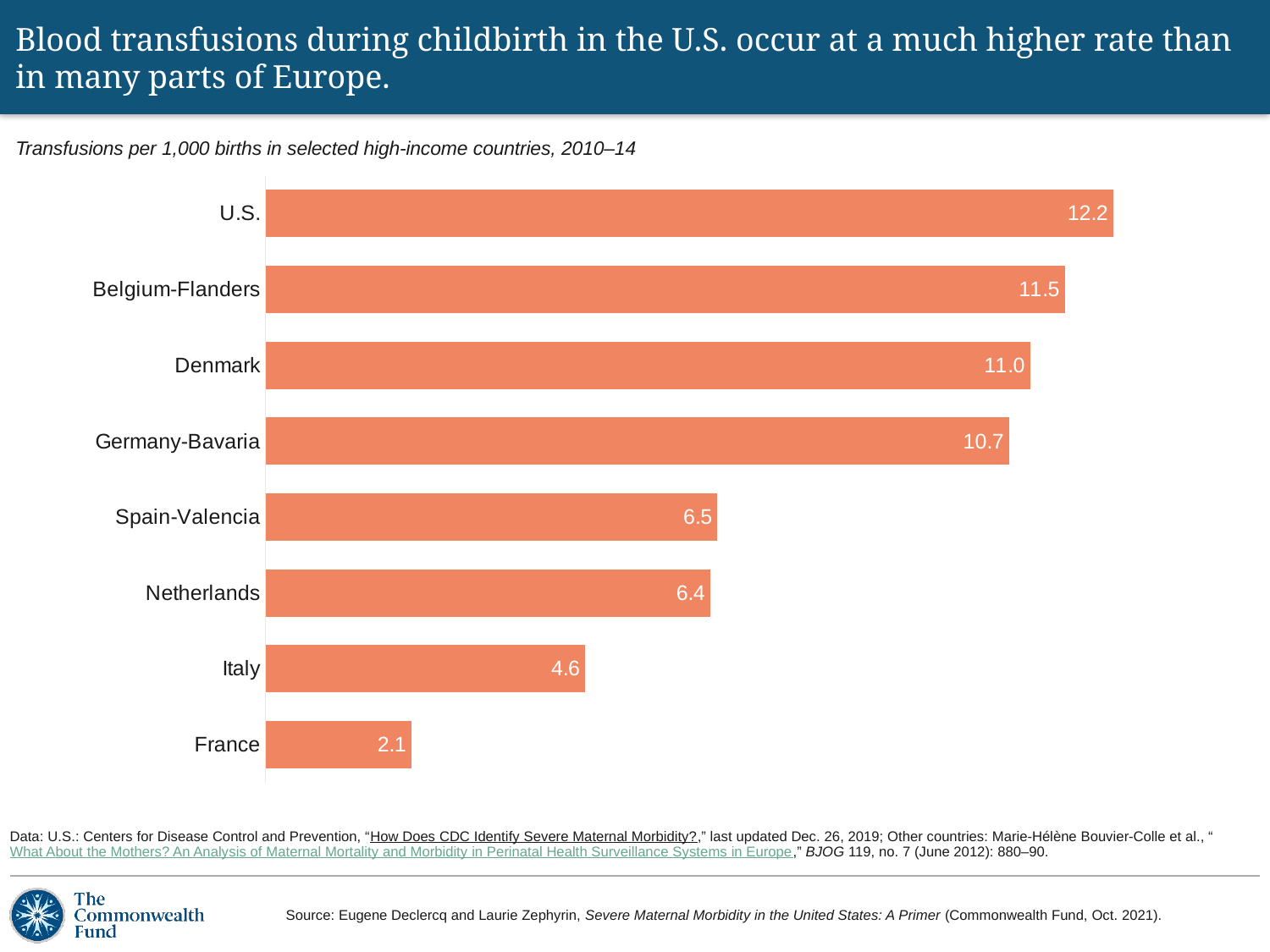
Which has a higher value, Denmark or Germany-Bavaria? Denmark How many countries or regions are shown in the chart? 8 What is the difference between the Denmark value and the France value? 8.9 What type of chart is shown on the slide? Bar chart Which country has the highest transfusion rate? U.S. What is the subtitle of the chart describing the measure plotted? Transfusions per 1,000 births in selected high-income countries, 2010–14 Which country has the lowest transfusion rate? France What is the difference between the U.S. value and the Belgium-Flanders value? 0.7 What is the transfusion rate per 1,000 births for the U.S.? 12.2 Which has a higher value, Italy or Spain-Valencia? Spain-Valencia What is the value shown for Germany-Bavaria? 10.7 What is the value shown for France? 2.1